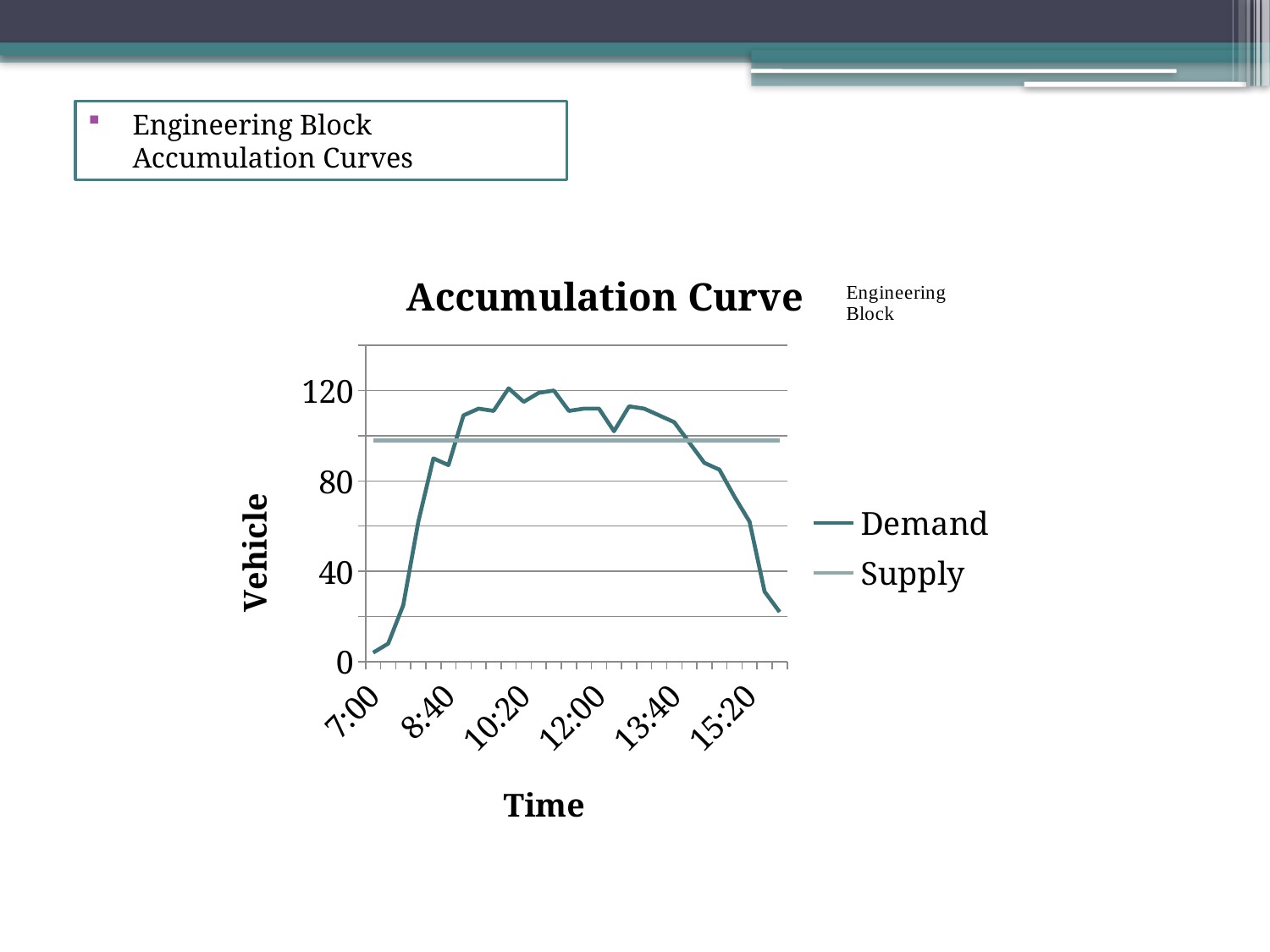
At 7:00, which series has the larger value, Demand or Supply? Supply Is the Supply value greater or less than 80? greater Is the Demand value at 10:20 greater or less than 80? greater How many series does the chart legend list? 2 How many time labels are shown on the x axis? 6 Is the Supply value greater or less than 120? less Does the Demand line rise or fall between 13:40 and 15:20? fall At 10:20, which series has the larger value, Demand or Supply? Demand What is the title of the chart? Accumulation Curve What are the two series named in the legend? Demand and Supply What kind of chart is shown on the slide? line chart